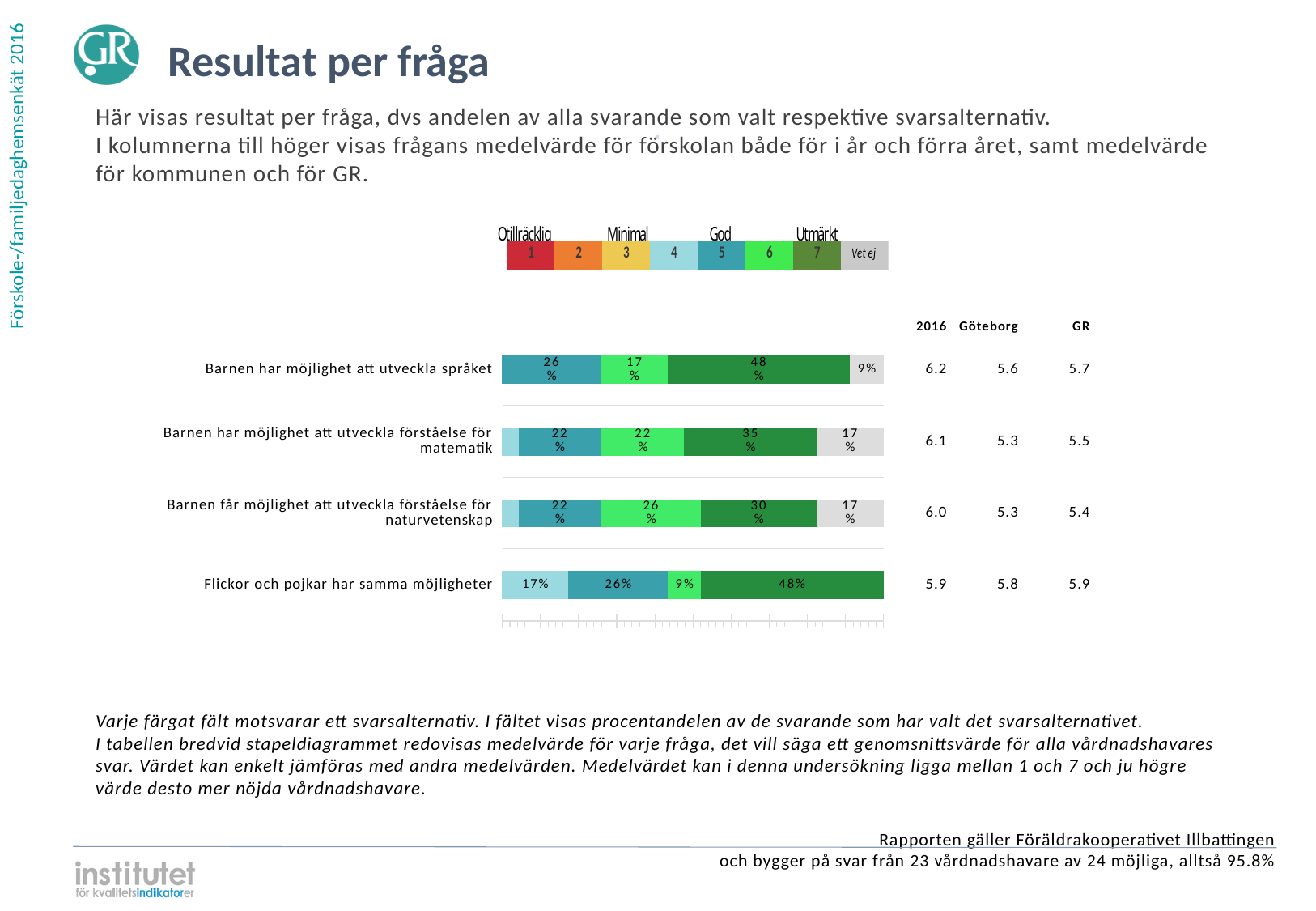
What percentage chose answer 6 (light green) for 'Barnen får möjlighet att utveckla förståelse för naturvetenskap'? 26% What is the 2016 mean value shown for 'Barnen har möjlighet att utveckla språket'? 6.2 What percentage chose answer 4 (light blue) for 'Flickor och pojkar har samma möjligheter'? 17% Which question has the largest share of answer 6 (light green)? Barnen får möjlighet att utveckla förståelse för naturvetenskap Which has a larger share of answer 7: 'Barnen har möjlighet att utveckla förståelse för matematik' or 'Barnen får möjlighet att utveckla förståelse för naturvetenskap'? Barnen har möjlighet att utveckla förståelse för matematik For 'Barnen har möjlighet att utveckla språket', what is the difference between the share choosing 7 and the share choosing 6? 31 percentage points What percentage of respondents chose answer 7 (dark green) for 'Barnen har möjlighet att utveckla språket'? 48% What is the total of the labelled segments for 'Flickor och pojkar har samma möjligheter'? 100% How many entries does the colour legend above the chart list? 8 What type of chart is shown on the slide? Stacked bar chart What percentage chose 'Vet ej' for 'Barnen har möjlighet att utveckla förståelse för matematik'? 17% How many questions (categories) are plotted in the bar chart? 4